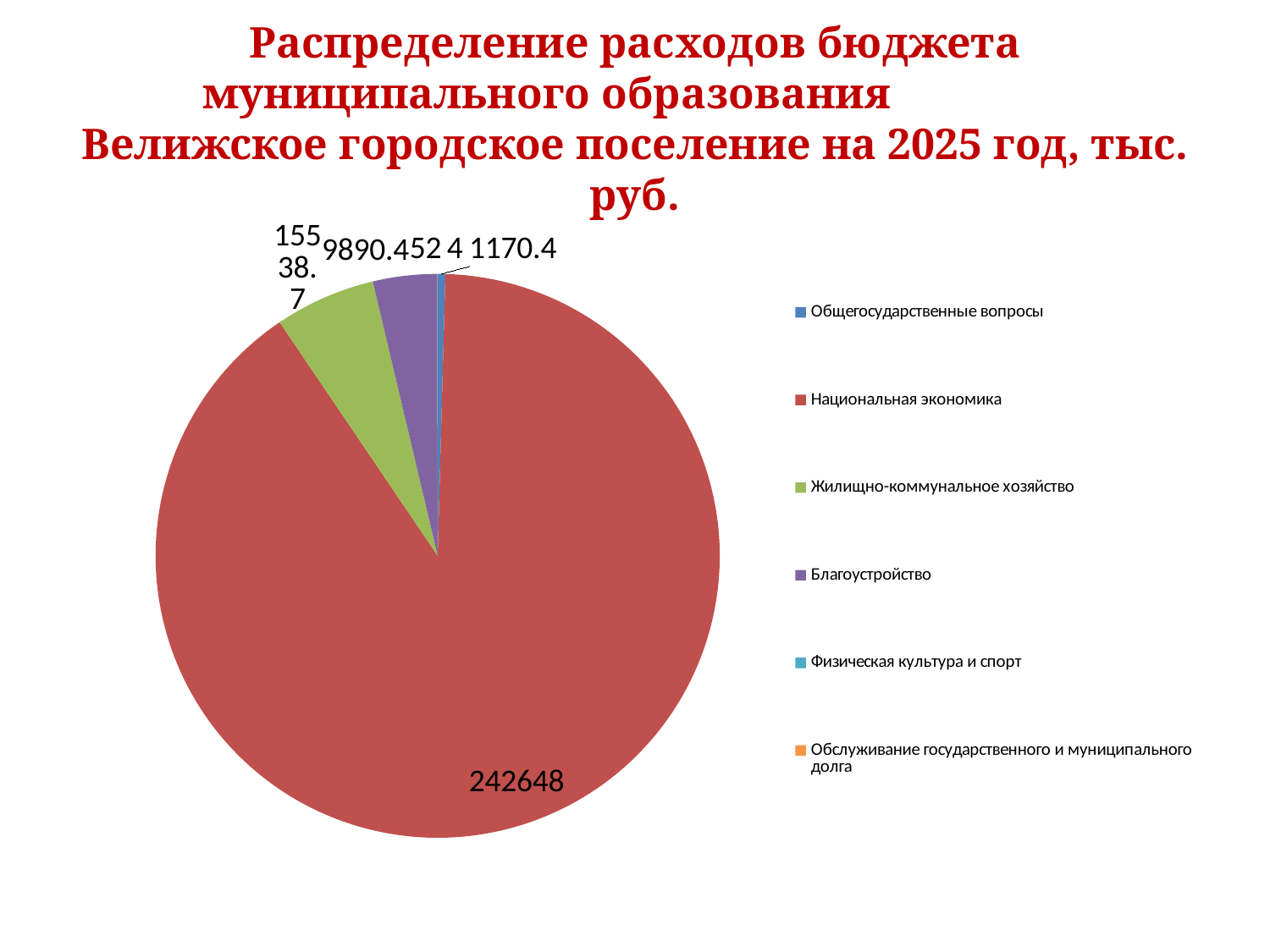
What colour is the slice for Национальная экономика? red Which is larger, the slice for Национальная экономика or the slice for Жилищно-коммунальное хозяйство? Национальная экономика How many categories does the legend of the pie chart list? 6 Which is larger, the slice for Жилищно-коммунальное хозяйство or the slice for Благоустройство? Жилищно-коммунальное хозяйство For which year does the chart show the distribution of budget expenditures? 2025 Which category has the largest slice of the pie? Национальная экономика What is the value shown for Национальная экономика? 242648 What is the value shown for Жилищно-коммунальное хозяйство? 15538.7 What kind of chart is shown on the slide? pie chart What is the difference between the values for Национальная экономика and Жилищно-коммунальное хозяйство? 227109.3